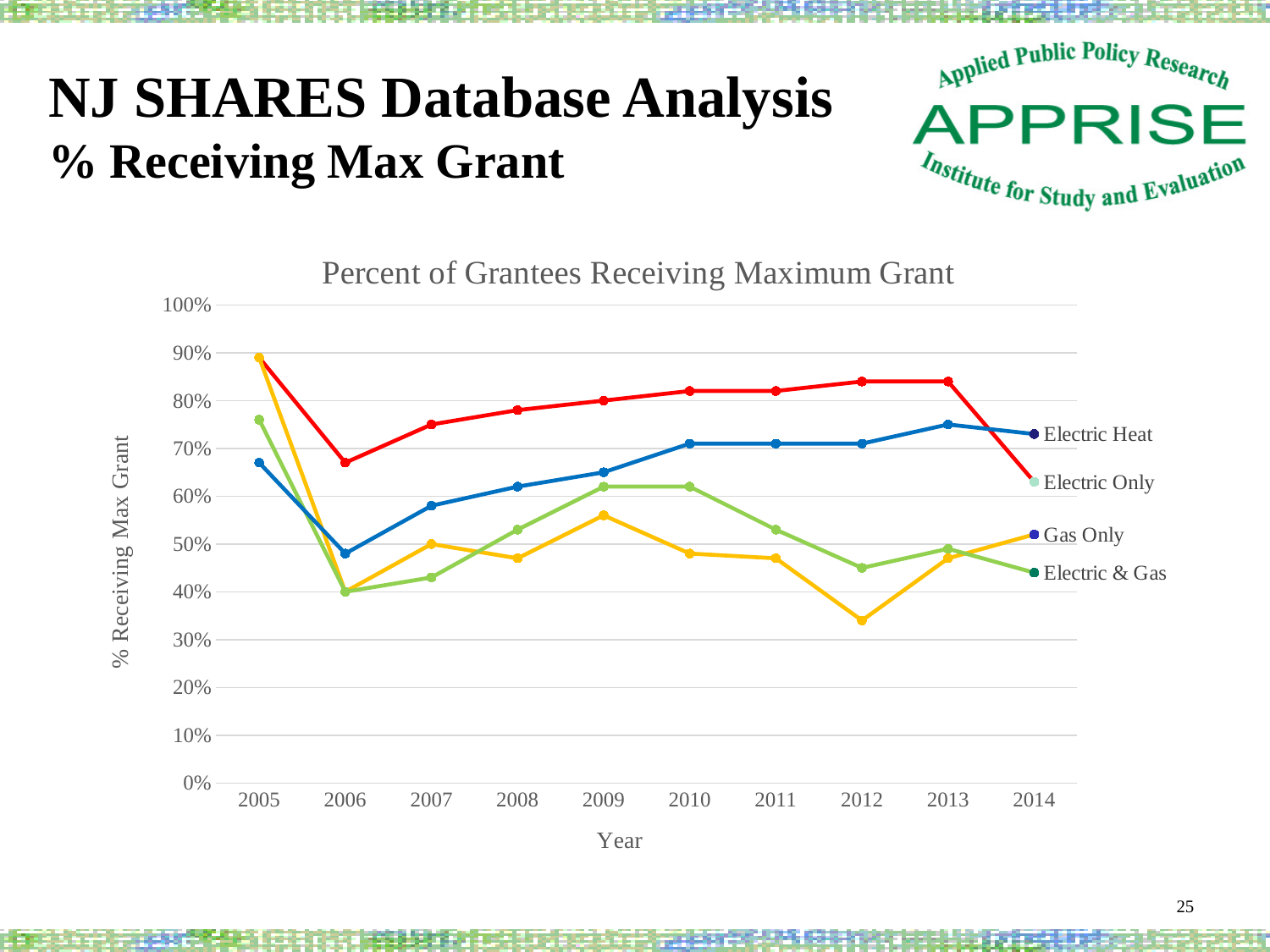
How many series are labelled on the chart? 4 In 2014, which is larger, Electric Heat or Electric & Gas? Electric Heat In 2014, is the value for Electric & Gas greater or less than 50%? less What is the title of the chart? Percent of Grantees Receiving Maximum Grant What is the value for Gas Only in 2007? 50% In 2014, is the value for Electric Heat greater or less than 70%? greater In 2014, is the value for Electric Only greater or less than 60%? greater How many years are shown on the x axis? 10 What kind of chart is shown on the slide? line chart What is the label of the y axis? % Receiving Max Grant Which series has the lowest value in 2014? Electric & Gas Which series has the highest value in 2014? Electric Heat